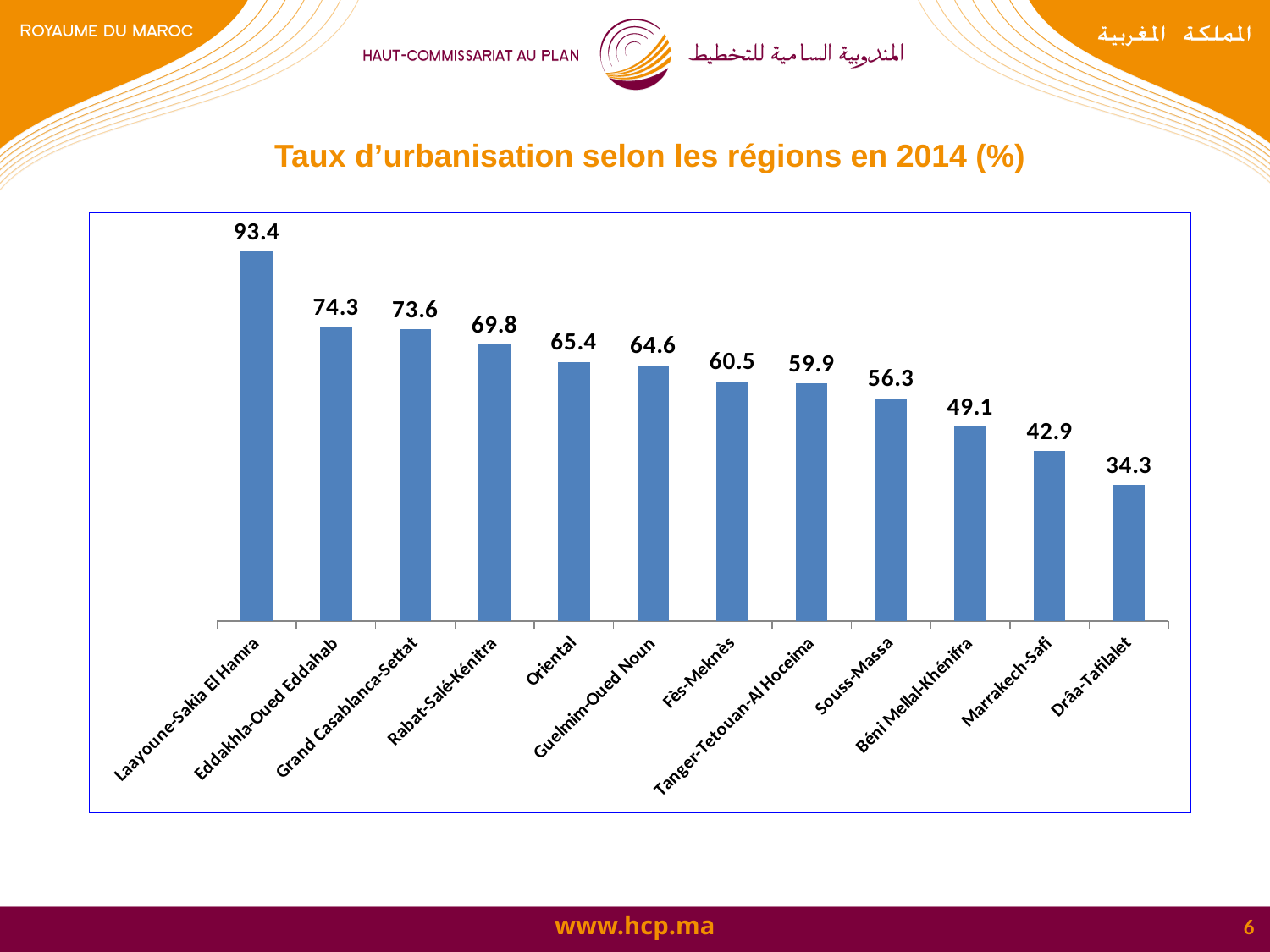
Which region has the lowest urbanisation rate? Drâa-Tafilalet What is the difference between the urbanisation rates of Eddakhla-Oued Eddahab and Grand Casablanca-Settat? 0.7 What kind of chart is shown on the slide? Bar chart How many regions are shown in the chart? 12 What is the urbanisation rate for Oriental? 65.4 Do the values rise or fall from left to right along the x axis? Fall What is the title of the chart? Taux d'urbanisation selon les régions en 2014 (%) Which has a higher urbanisation rate, Fès-Meknès or Marrakech-Safi? Fès-Meknès Which region has the highest urbanisation rate? Laayoune-Sakia El Hamra What is the difference between the urbanisation rates of Laayoune-Sakia El Hamra and Drâa-Tafilalet? 59.1 What is the urbanisation rate for Béni Mellal-Khénifra? 49.1 What is the urbanisation rate for Souss-Massa? 56.3